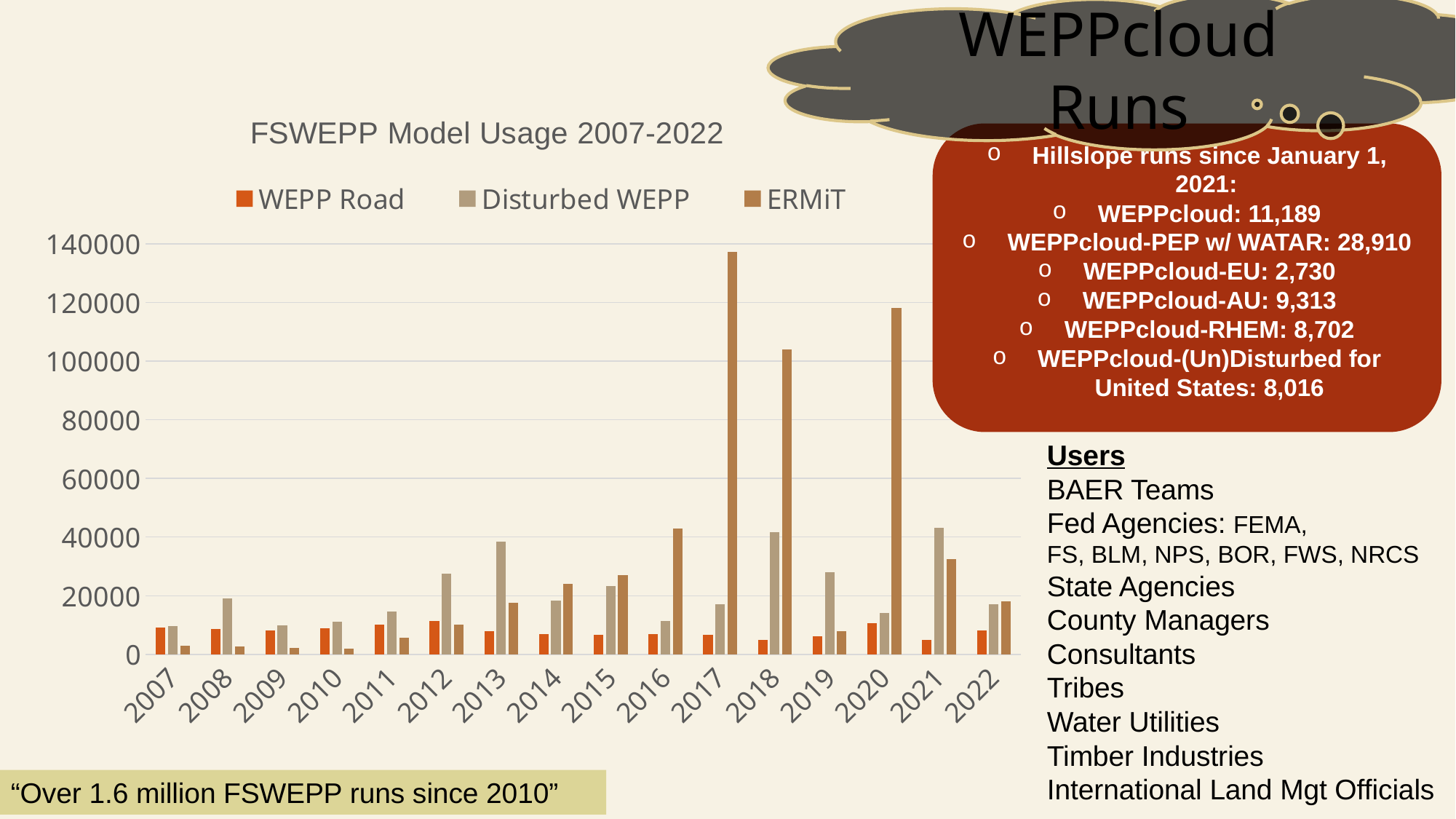
What is the title of the chart? FSWEPP Model Usage 2007-2022 Which series are listed in the chart legend? WEPP Road, Disturbed WEPP, ERMiT How many years are shown along the x axis of the chart? 16 What kind of chart is shown on the slide? bar chart Which is larger, the ERMiT value for 2017 or the ERMiT value for 2020? 2017 Is the Disturbed WEPP value for 2013 greater or less than 20000? greater Is the ERMiT value for 2018 greater or less than 80000? greater Is the ERMiT value for 2020 greater or less than 100000? greater Which is larger, the Disturbed WEPP value for 2008 or the Disturbed WEPP value for 2007? 2008 In which year does the ERMiT series reach its highest value? 2017 How many series does the chart legend list? 3